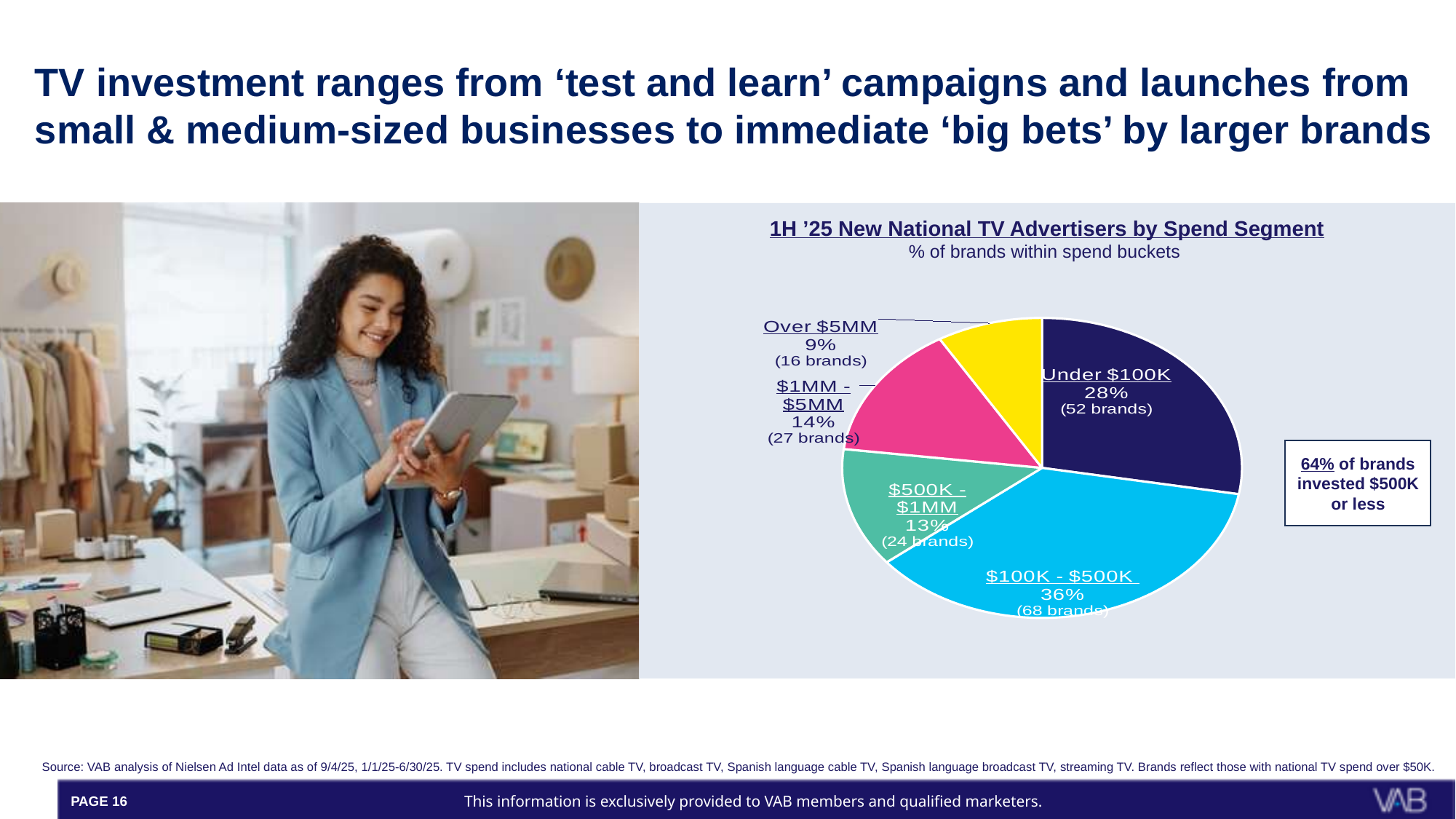
According to the callout box, what percentage of brands invested $500K or less? 64% Which spend segment has the smallest share of brands? Over $5MM What percentage of brands fall in the $100K - $500K spend segment? 36% How many brands are in the $1MM - $5MM segment? 27 brands Which segment has more brands, $500K - $1MM or $1MM - $5MM? $1MM - $5MM How many brands are in the Under $100K spend segment? 52 brands What percentage of brands spent Over $5MM? 9% How many spend segments are shown in the pie chart? 5 What is the title of the chart? 1H '25 New National TV Advertisers by Spend Segment Which spend segment has the largest share of brands? $100K - $500K What kind of chart is shown on the slide? Pie chart What is the difference in percentage points between the $100K - $500K segment and the Under $100K segment? 8 percentage points